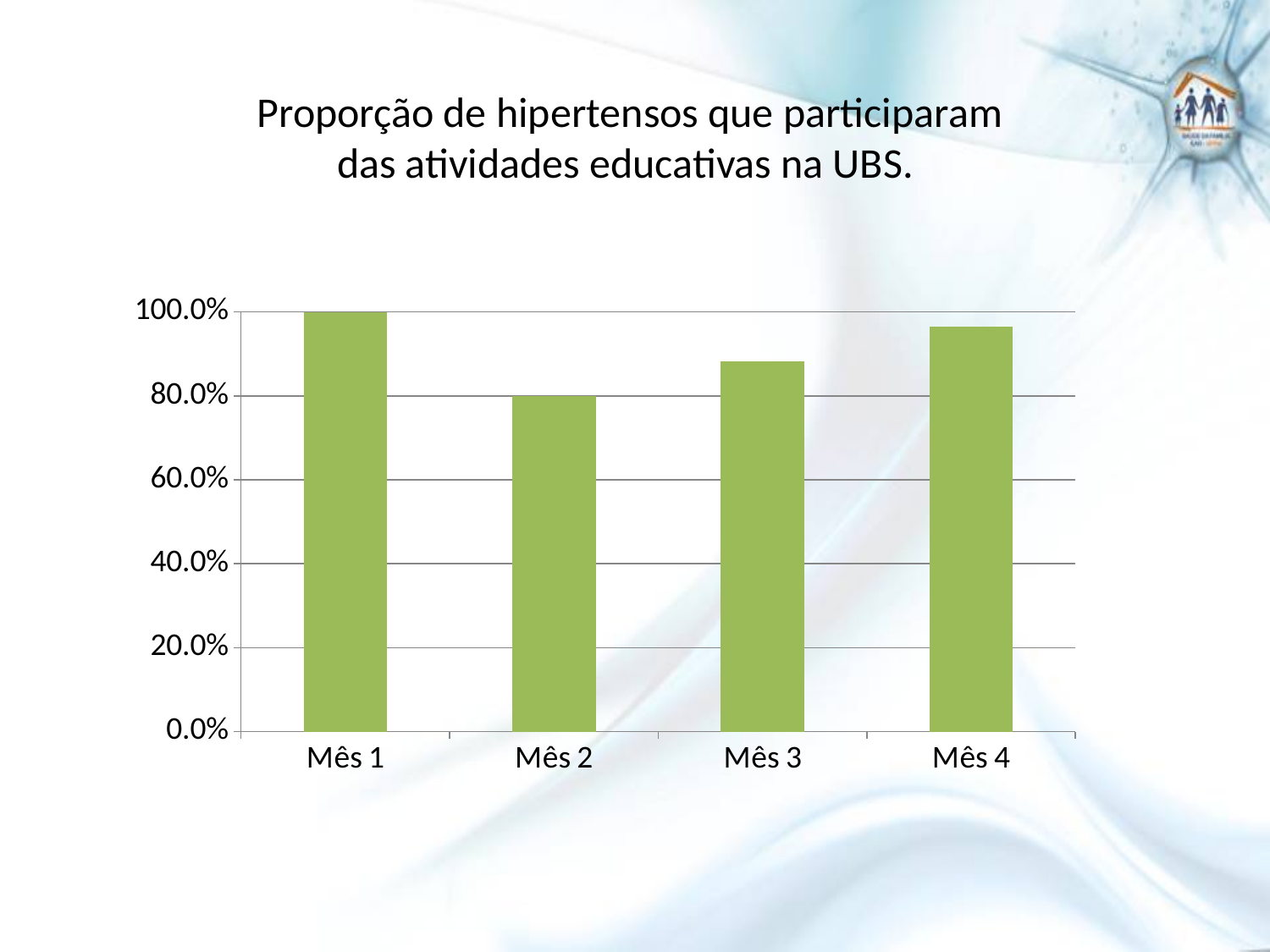
Do the values rise or fall from Mês 2 to Mês 4? rise Is the value for Mês 3 greater or less than 80.0%? greater What kind of chart is shown on the slide? bar chart Which is larger, the value for Mês 3 or the value for Mês 2? Mês 3 Is the value for Mês 4 greater or less than 100.0%? less Which month has the highest value? Mês 1 What is the value for Mês 2? 80.0% How many months (categories) are shown on the x axis? 4 What is the value for Mês 1? 100.0% Which is larger, the value for Mês 4 or the value for Mês 3? Mês 4 Which month has the lowest value? Mês 2 What is the difference between the values for Mês 1 and Mês 2? 20.0%